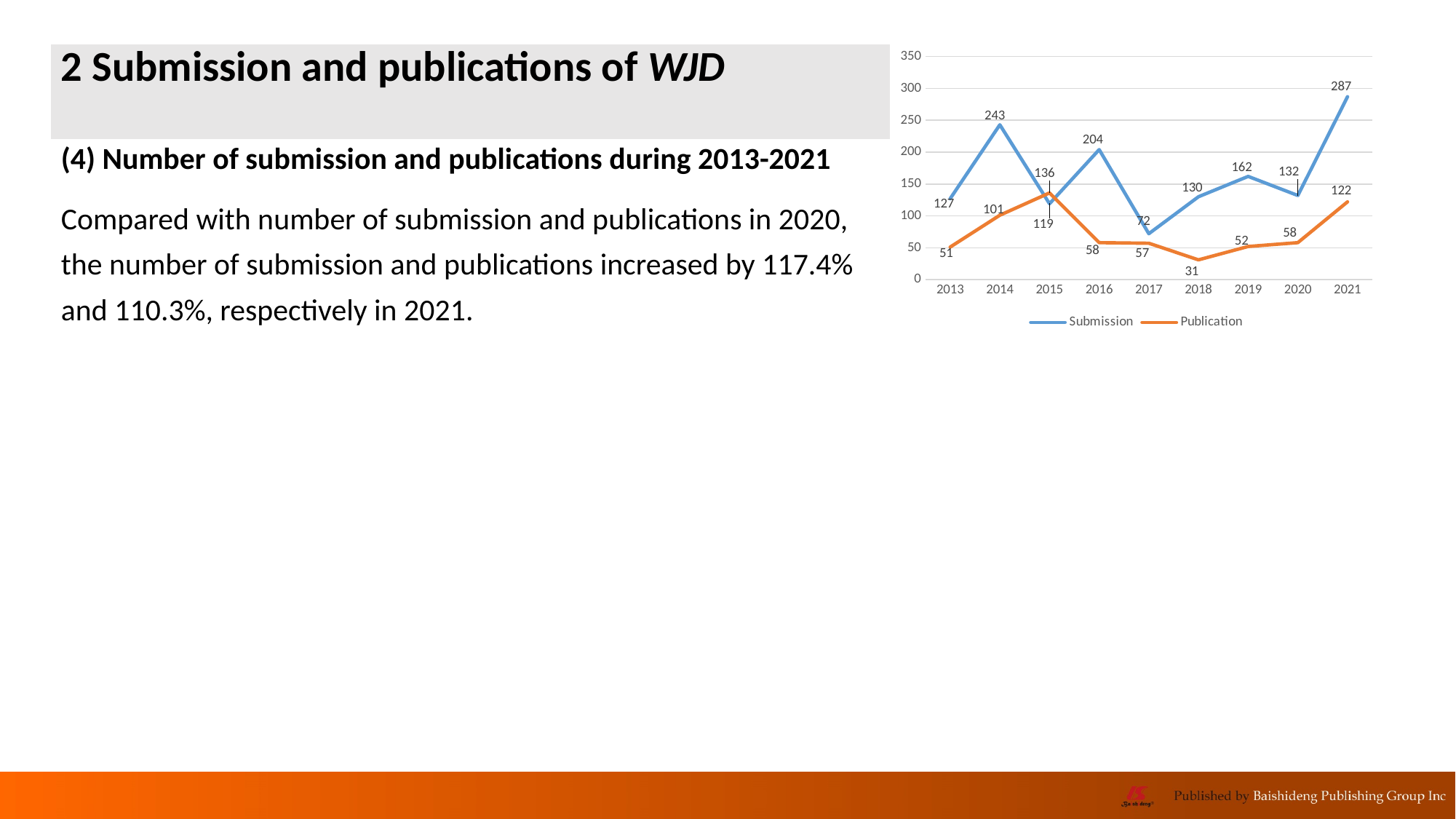
What kind of chart is shown on the slide? Line chart What is the Submission value for 2021? 287 By how much did the Submission value increase from 2020 to 2021? 155 How many series does the legend list? 2 What colour is the Publication line in the chart? Orange In 2015, which series has the larger value, Submission or Publication? Publication How many years are shown on the x axis? 9 What is the Publication value for 2018? 31 In which year is the Submission value highest? 2021 Does the Publication value rise or fall from 2018 to 2021? Rise In which year is the Publication value lowest? 2018 What is the Submission value for 2017? 72